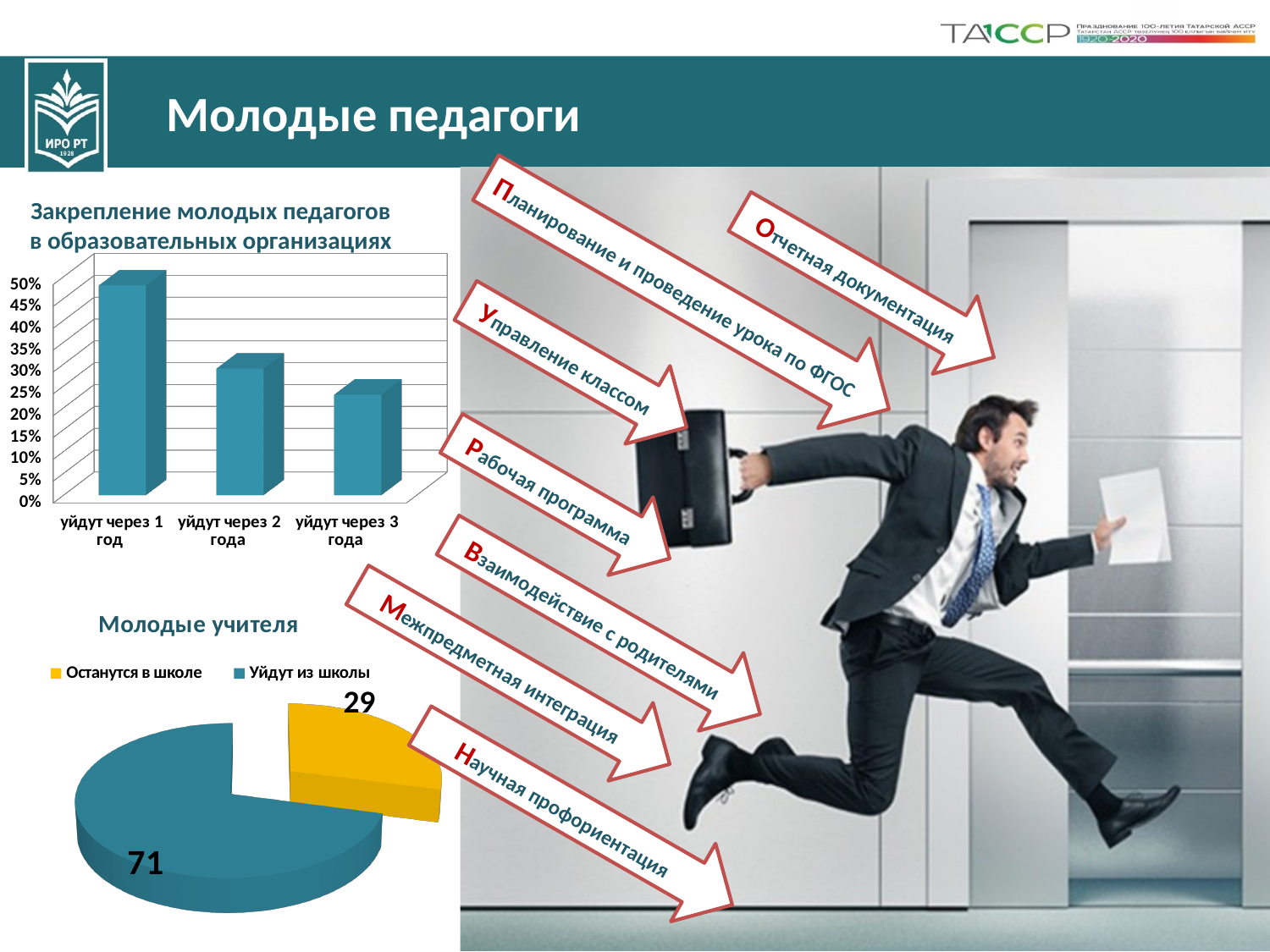
In the bar chart 'Закрепление молодых педагогов в образовательных организациях', which category has the highest value? уйдут через 1 год In the bar chart 'Закрепление молодых педагогов в образовательных организациях', how many categories are shown? 3 In the bar chart 'Закрепление молодых педагогов в образовательных организациях', is the value for 'уйдут через 3 года' greater or less than 30%? less In the pie chart 'Молодые учителя', what is the value for 'Останутся в школе'? 29 What kind of chart is 'Закрепление молодых педагогов в образовательных организациях'? bar chart In the bar chart 'Закрепление молодых педагогов в образовательных организациях', is the value for 'уйдут через 1 год' greater or less than 40%? greater In the pie chart 'Молодые учителя', what is the value for 'Уйдут из школы'? 71 In the bar chart 'Закрепление молодых педагогов в образовательных организациях', which category has the lowest value? уйдут через 3 года In the bar chart 'Закрепление молодых педагогов в образовательных организациях', do the values rise or fall from left to right? fall In the pie chart 'Молодые учителя', how many entries does the legend list? 2 In the pie chart 'Молодые учителя', what is the difference between 'Уйдут из школы' and 'Останутся в школе'? 42 In the bar chart 'Закрепление молодых педагогов в образовательных организациях', is the value for 'уйдут через 2 года' greater or less than 20%? greater